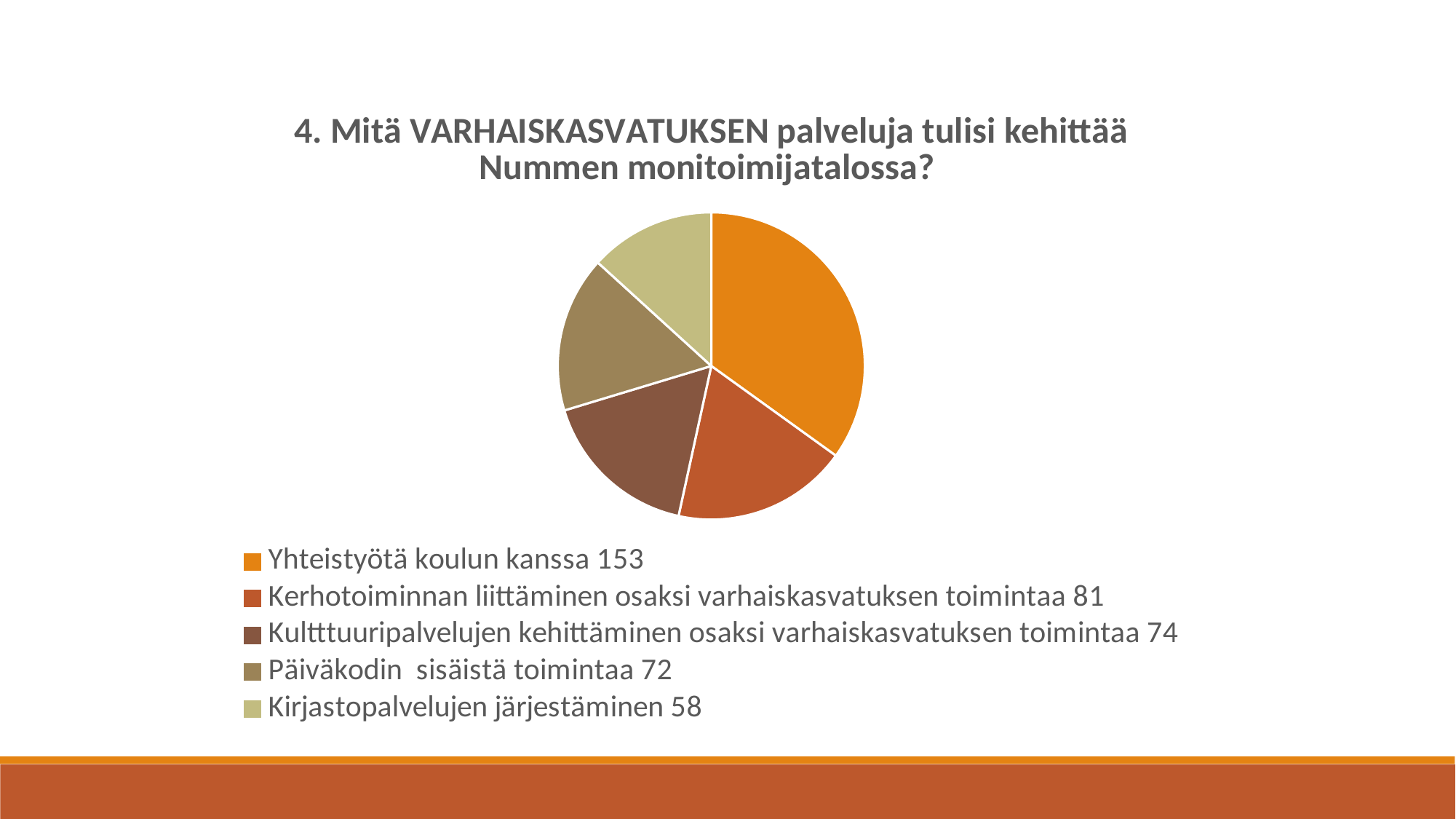
What is the title of the chart? 4. Mitä VARHAISKASVATUKSEN palveluja tulisi kehittää Nummen monitoimijatalossa? What is the value for Kerhotoiminnan liittäminen osaksi varhaiskasvatuksen toimintaa? 81 What is the value for Päiväkodin sisäistä toimintaa? 72 What is the value for Kirjastopalvelujen järjestäminen? 58 Which category has the largest slice of the pie? Yhteistyötä koulun kanssa What is the difference between the values for Yhteistyötä koulun kanssa and Kerhotoiminnan liittäminen osaksi varhaiskasvatuksen toimintaa? 72 Which category has the smallest slice of the pie? Kirjastopalvelujen järjestäminen What colour is the slice for Yhteistyötä koulun kanssa? orange Which is larger: the value for Kerhotoiminnan liittäminen osaksi varhaiskasvatuksen toimintaa or the value for Kirjastopalvelujen järjestäminen? Kerhotoiminnan liittäminen osaksi varhaiskasvatuksen toimintaa How many slices does the pie chart have? 5 What is the value for Yhteistyötä koulun kanssa? 153 What type of chart is shown on the slide? pie chart